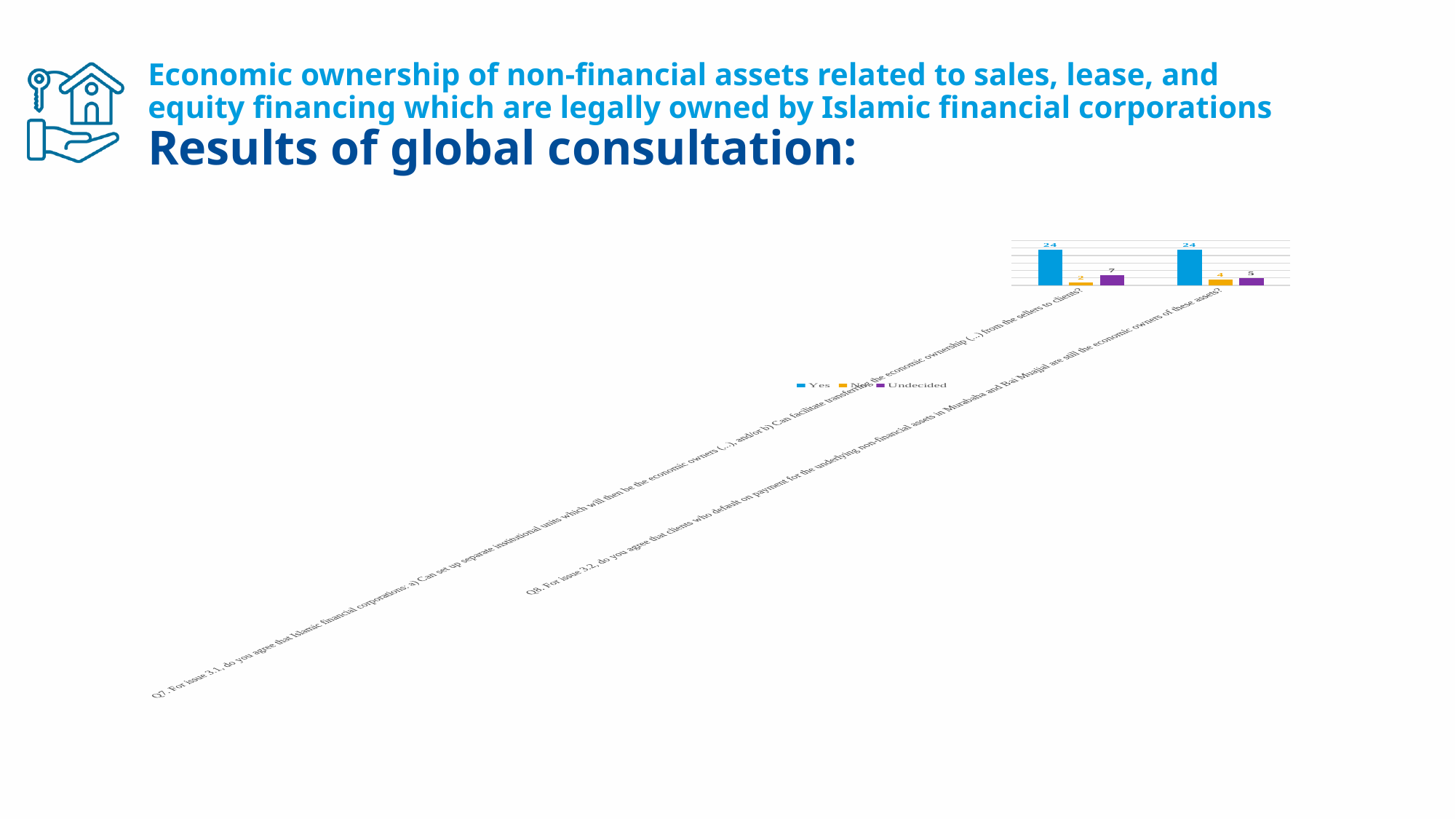
What is the difference between the "Yes" and "Undecided" values for Q7? 17 What colour are the "Yes" bars in the chart? Blue What kind of chart is shown on the slide? Bar chart How many series does the legend list? 3 What is the value for "No" for Q7? 2 Which response has the highest value for Q8? Yes What is the value for "Yes" for Q7? 24 What is the value for "No" for Q8? 4 Which response has the lowest value for Q7? No What is the value for "Undecided" for Q7? 7 Which is larger: the "Undecided" value for Q7 or the "Undecided" value for Q8? Q7 What is the value for "Undecided" for Q8? 5